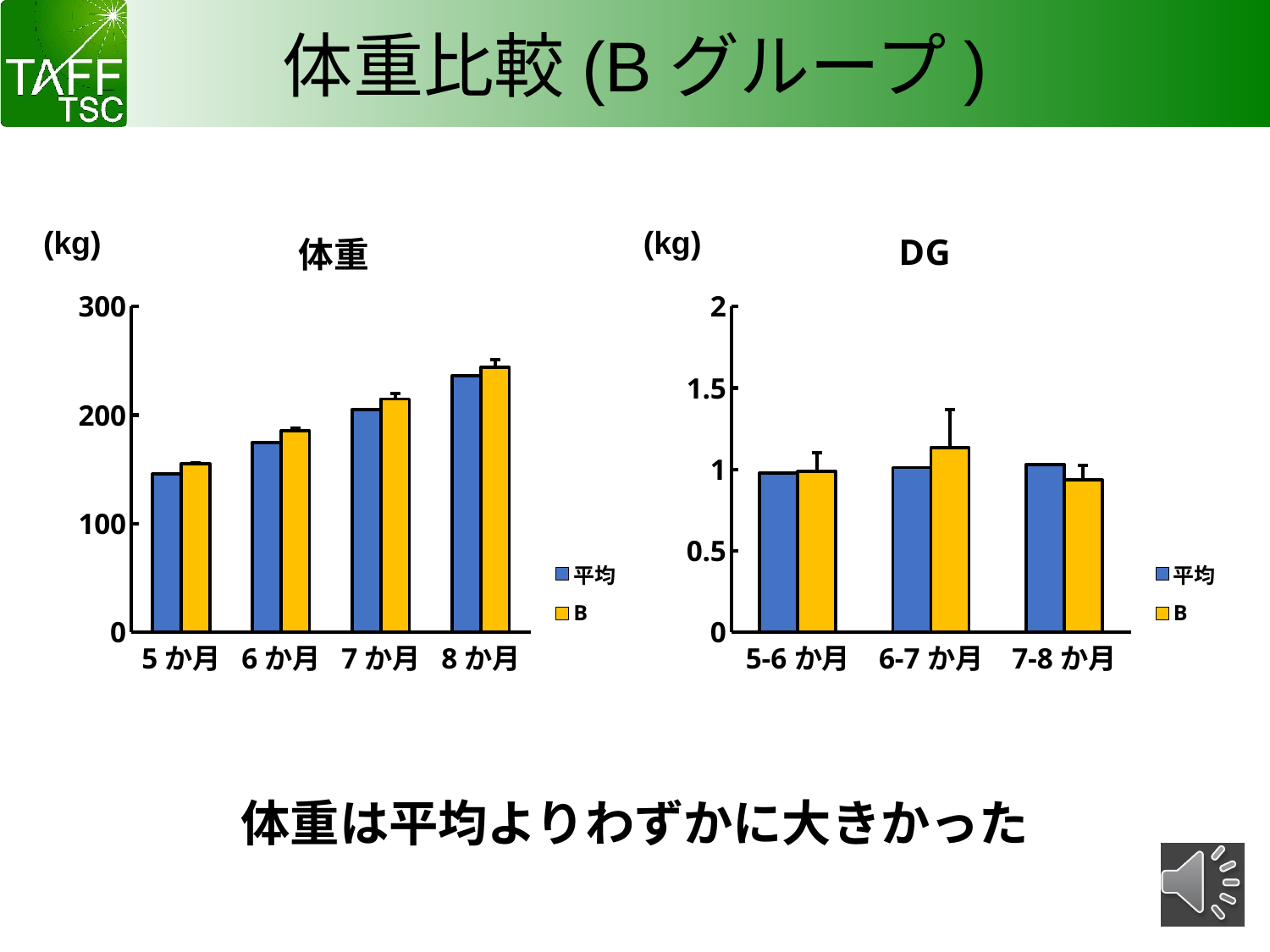
In the 体重 chart on the left, do the values for B rise or fall from 5 か月 to 8 か月? rise What is the title of the chart on the right? DG In the 体重 chart on the left, is the value for B at 5 か月 greater or less than 200? less What kind of chart is the 体重 chart on the left? bar chart In the 体重 chart on the left, which category has the lowest value for 平均? 5 か月 In the 体重 chart on the left, which category has the highest value for B? 8 か月 How many series does the legend of the DG chart on the right list? 2 In the 体重 chart on the left, is the value for 平均 at 8 か月 greater or less than 200? greater In the 体重 chart on the left, is the value for 平均 at 6 か月 greater or less than 200? less In the DG chart on the right, which is larger at 6-7 か月, 平均 or B? B In the DG chart on the right, which is larger at 7-8 か月, 平均 or B? 平均 How many categories are shown on the x axis of the 体重 chart on the left? 4